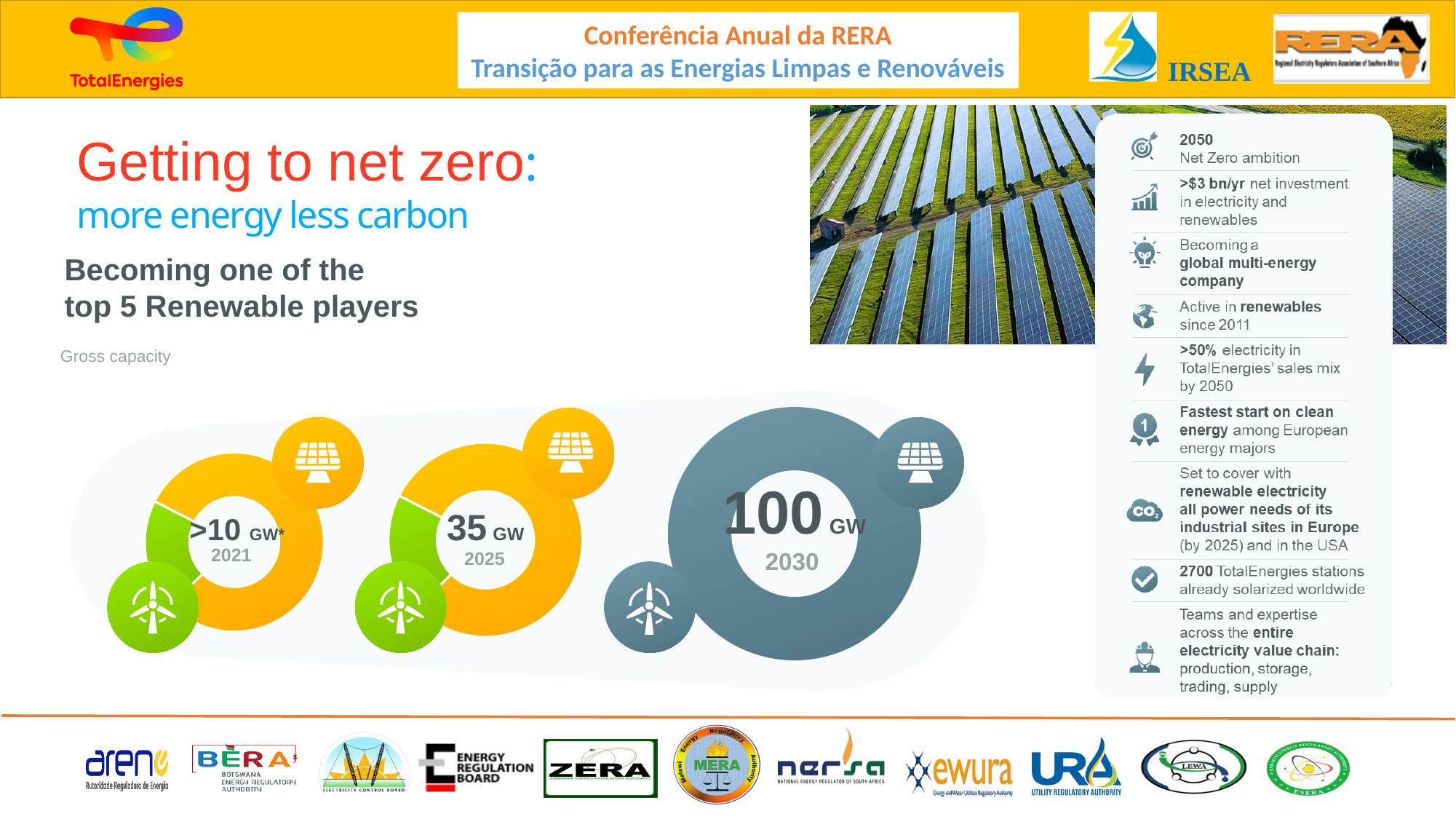
How many years (milestones) are shown in the gross capacity graphic? 3 Which year shows the highest gross capacity? 2030 Is the gross capacity for 2030 larger or smaller than for 2025? larger Which year shows the lowest gross capacity? 2021 What is the difference in gross capacity between 2030 and 2025? 65 GW What colour is the ring for the 2030 milestone? grey-blue What gross capacity is shown for 2030? 100 GW What label appears above the gross capacity graphic? Gross capacity What gross capacity is shown for 2025? 35 GW What kind of chart is used to show the gross capacity milestones? donut (ring) chart What gross capacity is shown for 2021? >10 GW* Does the gross capacity rise or fall from 2021 to 2030? rise